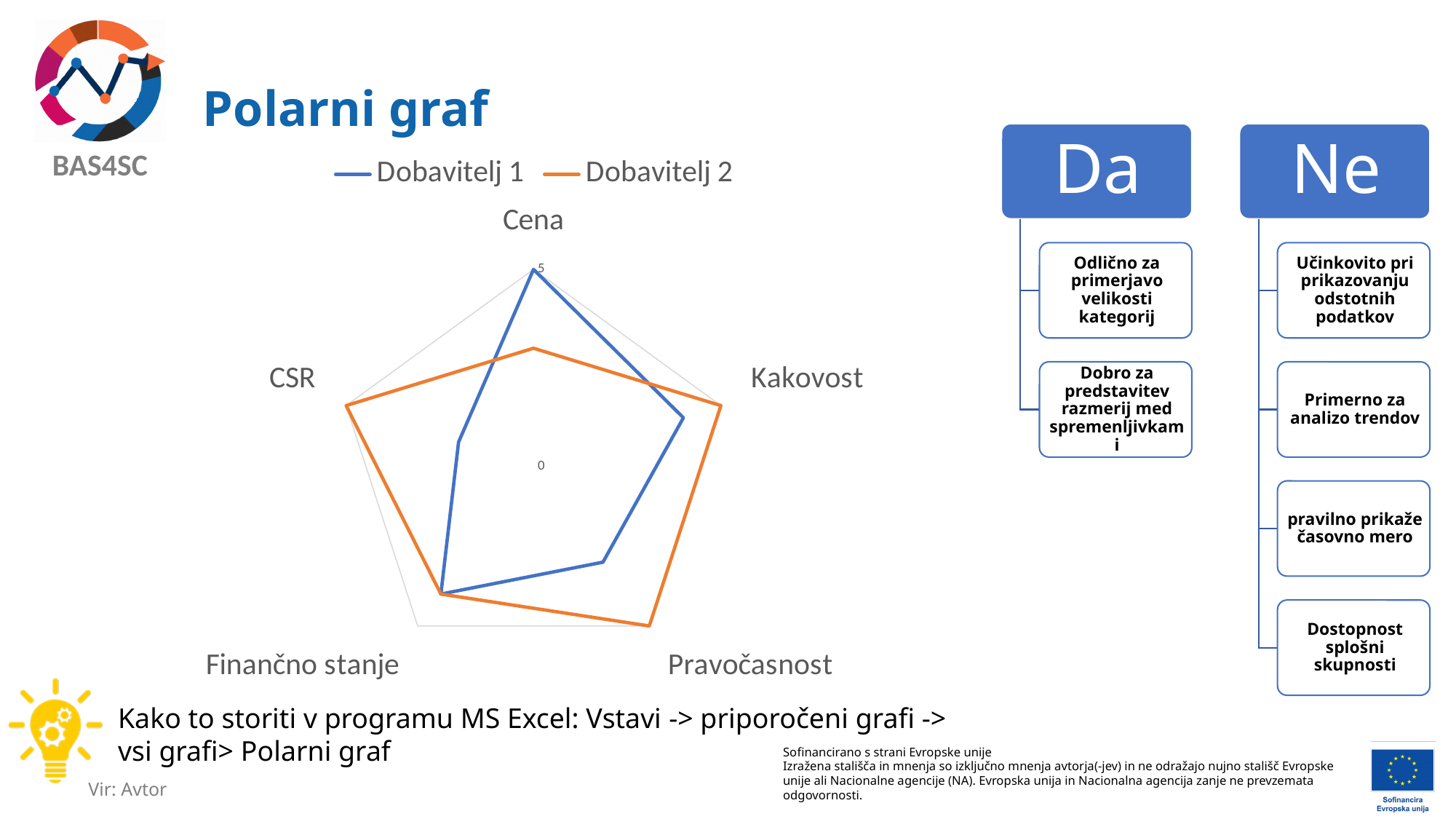
What colour is the line for Dobavitelj 2? orange What is the value for Dobavitelj 1 on the Cena axis? 5 How many categories (axes) does the radar chart have? 5 On which axis does Dobavitelj 2 have its lowest value? Cena What kind of chart is shown on the slide? radar chart Which series has the larger value on the CSR axis, Dobavitelj 1 or Dobavitelj 2? Dobavitelj 2 What is the value for Dobavitelj 2 on the Kakovost axis? 5 How many series does the legend list? 2 On which axis does Dobavitelj 1 reach its highest value? Cena Which series has the larger value on the Pravočasnost axis, Dobavitelj 1 or Dobavitelj 2? Dobavitelj 2 Which series has the larger value on the Cena axis, Dobavitelj 1 or Dobavitelj 2? Dobavitelj 1 What is the value for Dobavitelj 2 on the CSR axis? 5